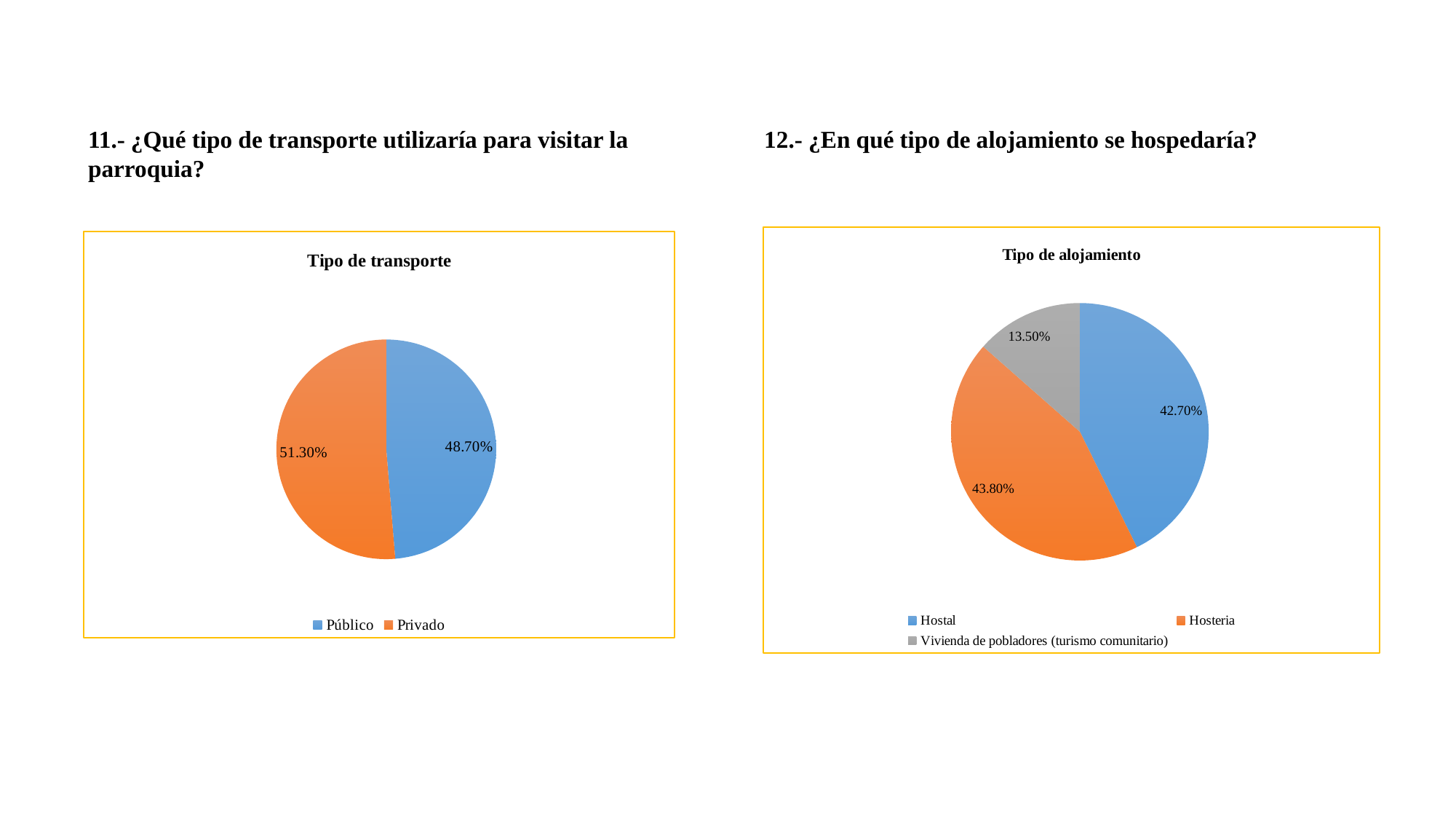
What kind of chart is the 'Tipo de transporte' chart? Pie chart In the 'Tipo de alojamiento' chart, which colour represents Hosteria? Orange In the 'Tipo de alojamiento' chart, what percentage is shown for Vivienda de pobladores (turismo comunitario)? 13.50% In the 'Tipo de alojamiento' chart, what is the difference between the Hosteria and Hostal shares? 1.10% In the 'Tipo de alojamiento' chart, what percentage is shown for Hosteria? 43.80% In the 'Tipo de alojamiento' chart, what percentage is shown for Hostal? 42.70% In the 'Tipo de transporte' chart, what percentage is shown for Público? 48.70% In the 'Tipo de alojamiento' chart, which category has the smallest share? Vivienda de pobladores (turismo comunitario) In the 'Tipo de transporte' chart, what is the difference between the Privado and Público shares? 2.60% In the 'Tipo de transporte' chart, which category has the larger share? Privado In the 'Tipo de transporte' chart, what percentage is shown for Privado? 51.30% In the 'Tipo de alojamiento' chart, how many categories does the legend list? 3